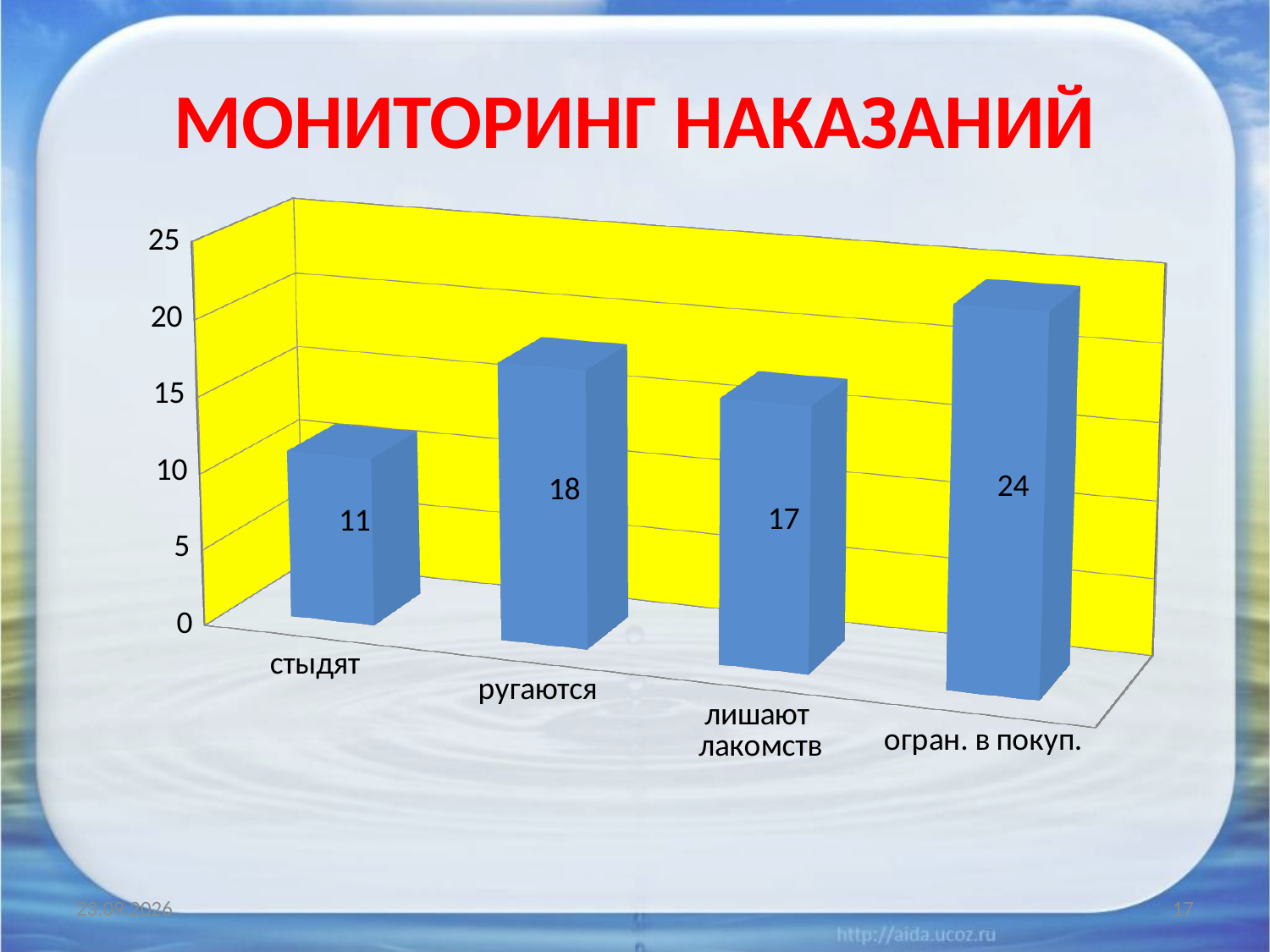
How many categories are shown on the chart? 4 What is the title of the slide? МОНИТОРИНГ НАКАЗАНИЙ Which category has the highest value? огран. в покуп. What is the difference between the values for огран. в покуп. and стыдят? 13 Which is larger, the value for ругаются or the value for стыдят? ругаются What is the value for лишают лакомств? 17 What is the value for стыдят? 11 What is the difference between the values for ругаются and лишают лакомств? 1 What kind of chart is shown on the slide? bar chart What is the value for огран. в покуп.? 24 Which category has the lowest value? стыдят What is the value for ругаются? 18